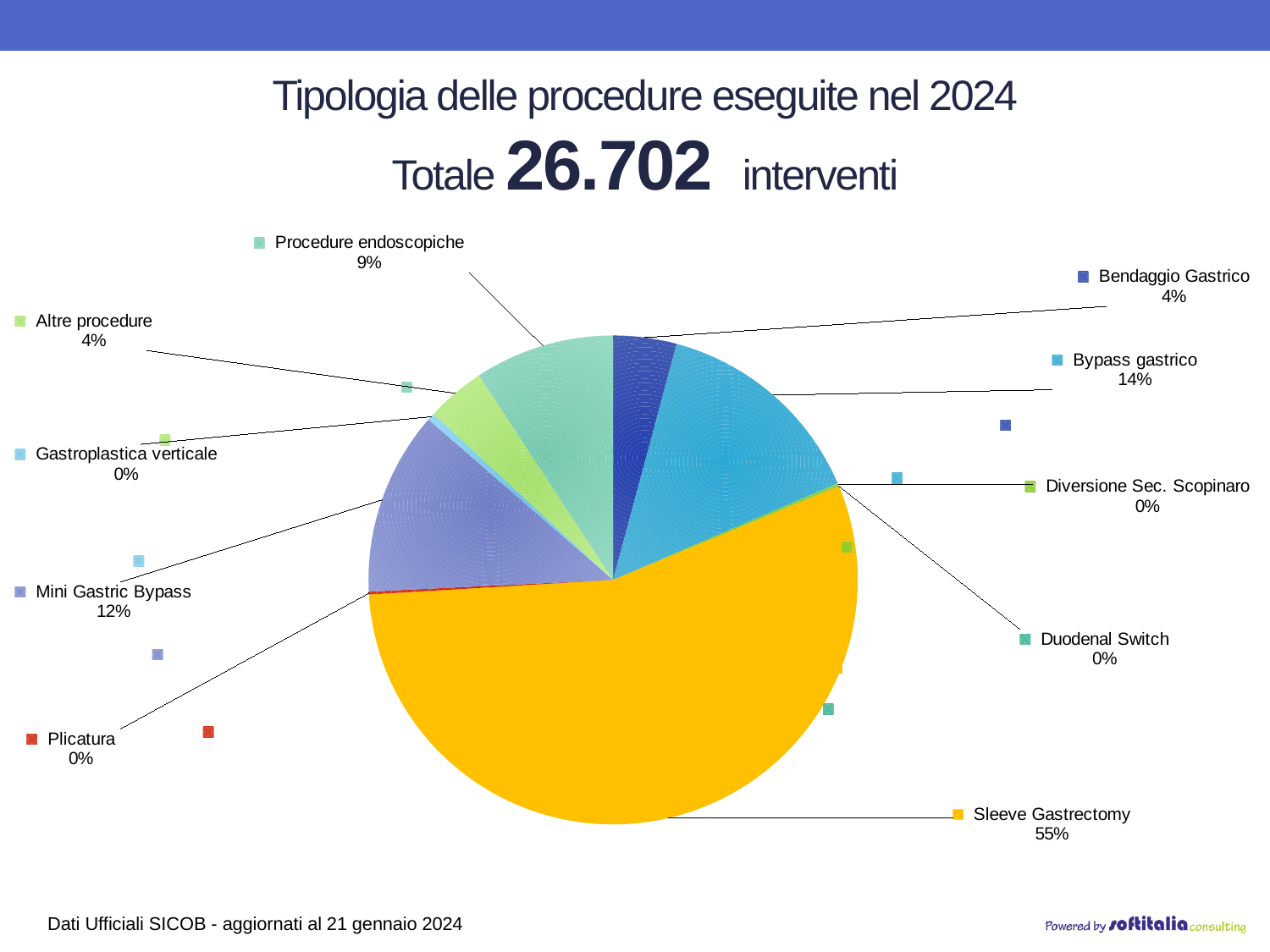
What share of the pie does Sleeve Gastrectomy represent? 55% What kind of chart is shown on the slide? pie chart What percentage is shown for Mini Gastric Bypass? 12% How many categories are labelled in the pie chart? 10 What percentage is shown for Procedure endoscopiche? 9% What is the difference in percentage points between Sleeve Gastrectomy and Bypass gastrico? 41 What percentage is shown for Bendaggio Gastrico? 4% Which is larger, the share for Bypass gastrico or the share for Mini Gastric Bypass? Bypass gastrico What is the total number of interventions stated in the chart title? 26.702 What percentage is shown for Plicatura? 0% Which procedure has the largest share of the pie? Sleeve Gastrectomy What percentage is shown for Bypass gastrico? 14%